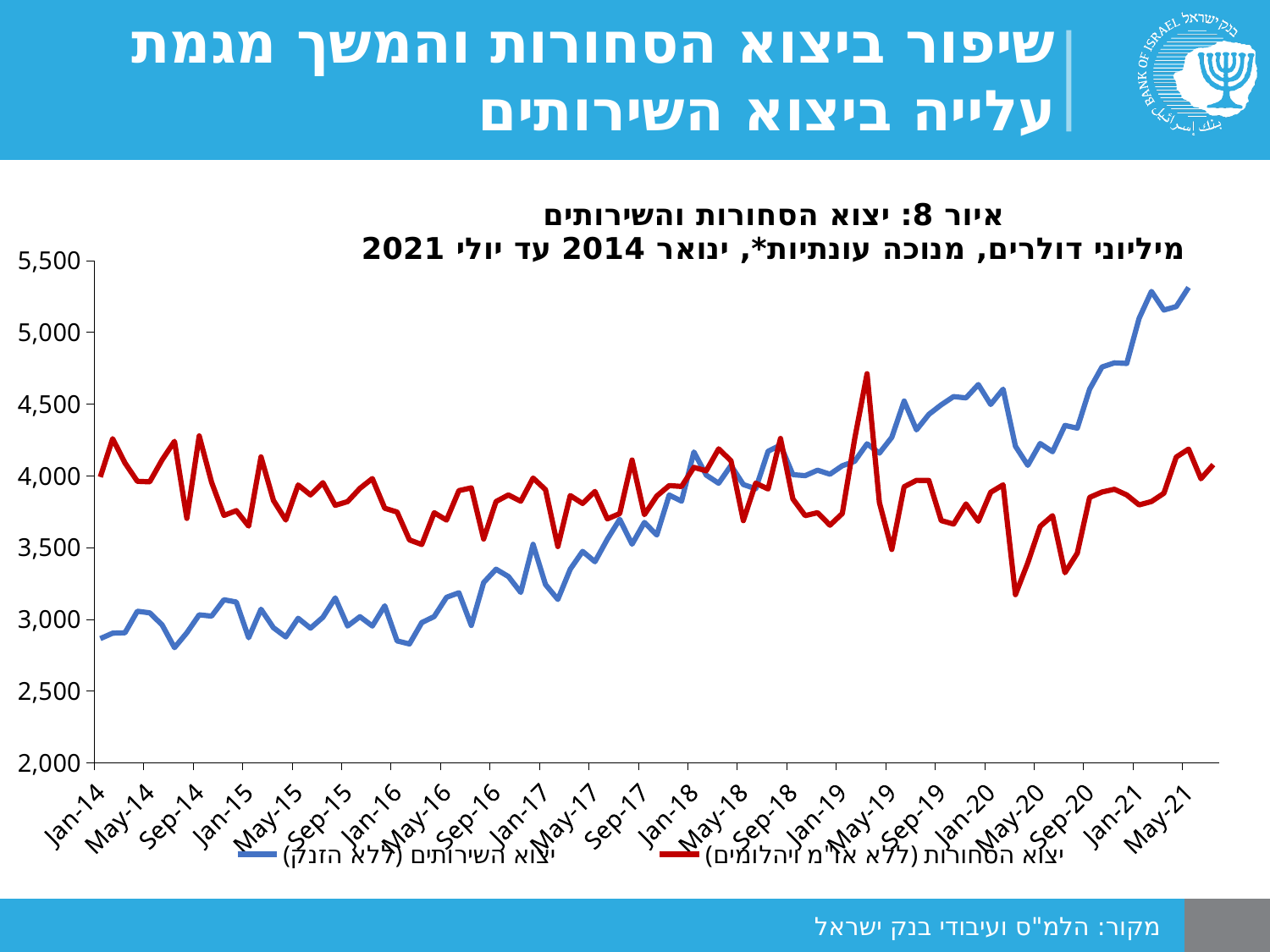
Is the value of יצוא השירותים (ללא הזנק) at Jan-14 greater or less than 3,000? less What is the title of the chart? איור 8: יצוא הסחורות והשירותים How many series does the legend list? 2 Does the יצוא השירותים (ללא הזנק) series generally rise or fall from Jan-14 to May-21? rise At May-21, which series has the higher value, יצוא השירותים or יצוא הסחורות? יצוא השירותים At Jan-14, which series has the higher value, יצוא השירותים or יצוא הסחורות? יצוא הסחורות Is the value of יצוא השירותים (ללא הזנק) at May-21 greater or less than 5,000? greater What kind of chart is shown on the slide? Line chart Is the value of יצוא השירותים (ללא הזנק) at Jan-21 greater or less than 4,500? greater Which series is shown in blue according to the legend? יצוא השירותים (ללא הזנק)